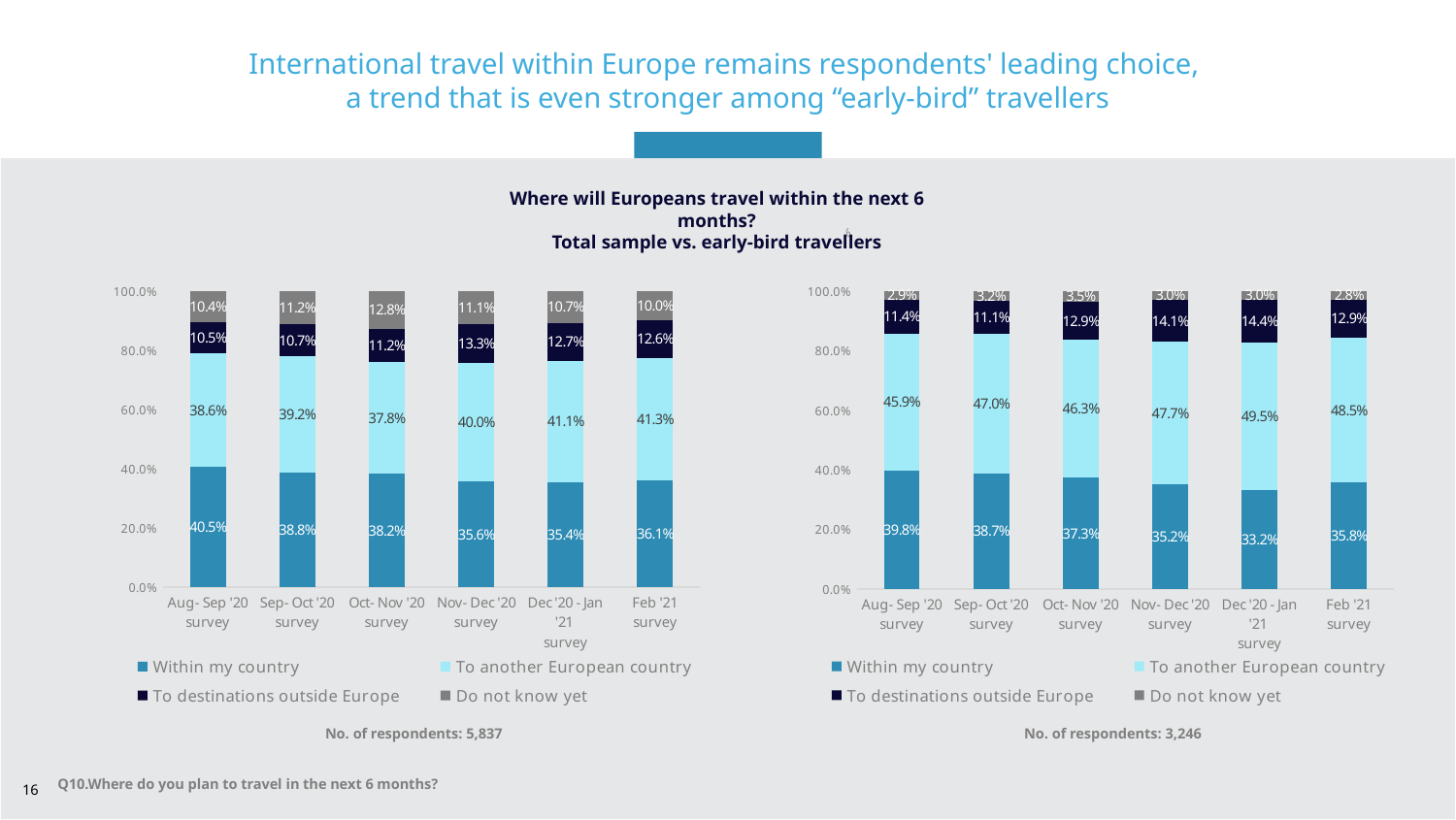
In the right chart (early-bird travellers), what share of respondents in the Dec '20 - Jan '21 survey planned to travel to another European country? 49.5% In the left chart (total sample), what share of respondents in the Nov - Dec '20 survey planned to travel to destinations outside Europe? 13.3% How many survey waves are shown on the x axis of the left chart? 6 In the left chart (total sample), what share of respondents in the Feb '21 survey planned to travel within their own country? 36.1% How many respondents are reported for the right chart (early-bird travellers)? 3,246 In the left chart (total sample), what is the difference between the 'Within my country' share in the Aug - Sep '20 survey and in the Feb '21 survey? 4.4% In the right chart (early-bird travellers), does the 'Within my country' share rise or fall from the Aug - Sep '20 survey to the Dec '20 - Jan '21 survey? Fall In the right chart (early-bird travellers), which survey wave has the highest share for 'To another European country'? Dec '20 - Jan '21 survey In the left chart (total sample), which survey wave has the lowest share for 'Within my country'? Dec '20 - Jan '21 survey In the Feb '21 survey, which chart shows a larger 'To another European country' share: the left chart (total sample) or the right chart (early-bird travellers)? Right chart (early-bird travellers) What type of chart is used on the left side of the slide? Stacked bar chart How many series does the legend of the right chart list? 4